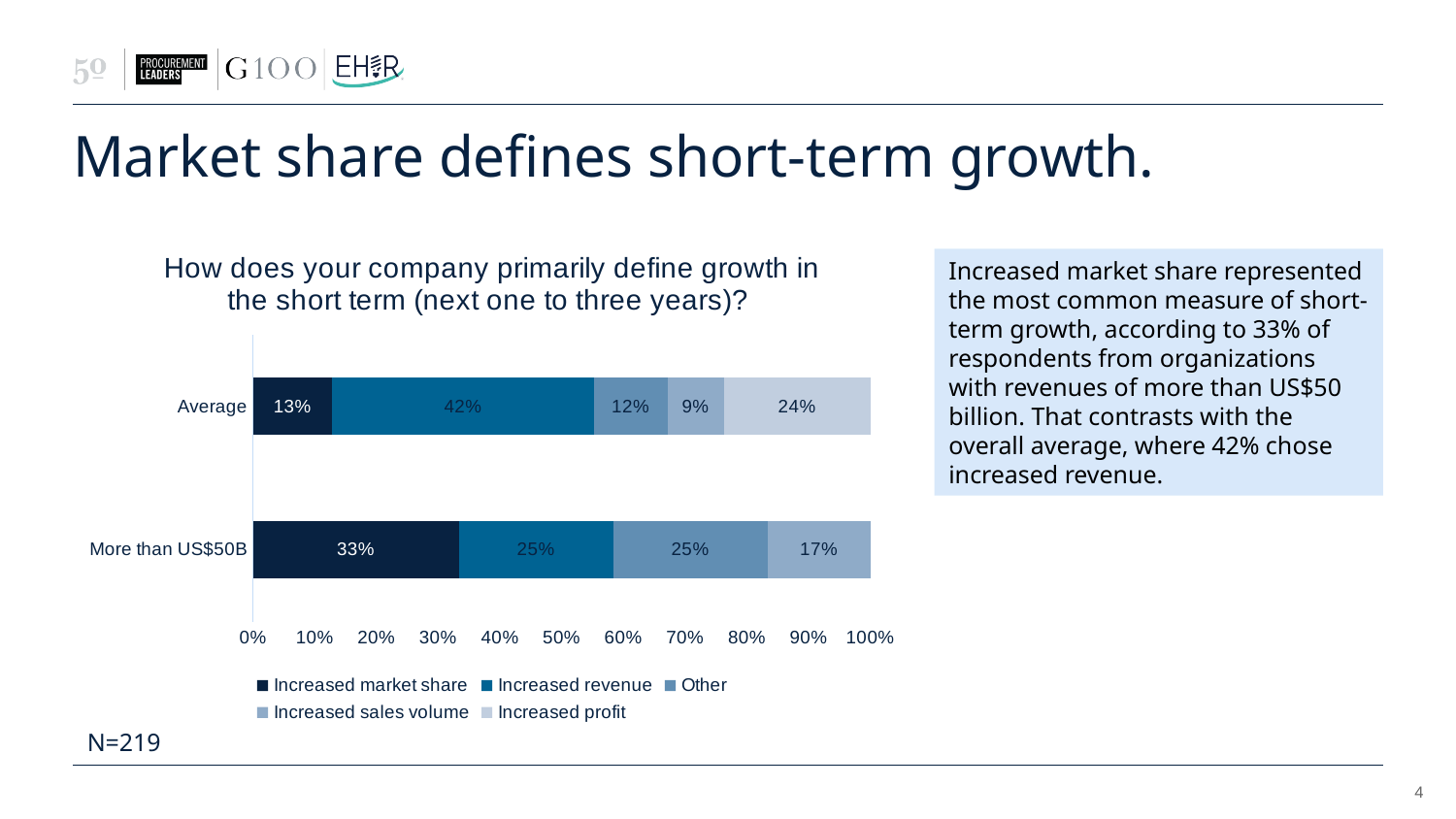
Which is larger: Increased revenue for Average or Increased revenue for More than US$50B? Average Which segment is the largest in the Average bar? Increased revenue Which segment is the smallest in the Average bar? Increased sales volume How many categories (bars) are shown in the chart? 2 What kind of chart is shown on the slide? Stacked bar chart What percentage of the More than US$50B bar is Increased market share? 33% What percentage of the Average bar is Increased revenue? 42% What percentage of the More than US$50B bar is Increased sales volume? 17% How many series does the chart legend list? 5 What is the difference between the Increased market share values for More than US$50B and Average? 20% What is the title of the chart? How does your company primarily define growth in the short term (next one to three years)? What percentage of the Average bar is Increased profit? 24%